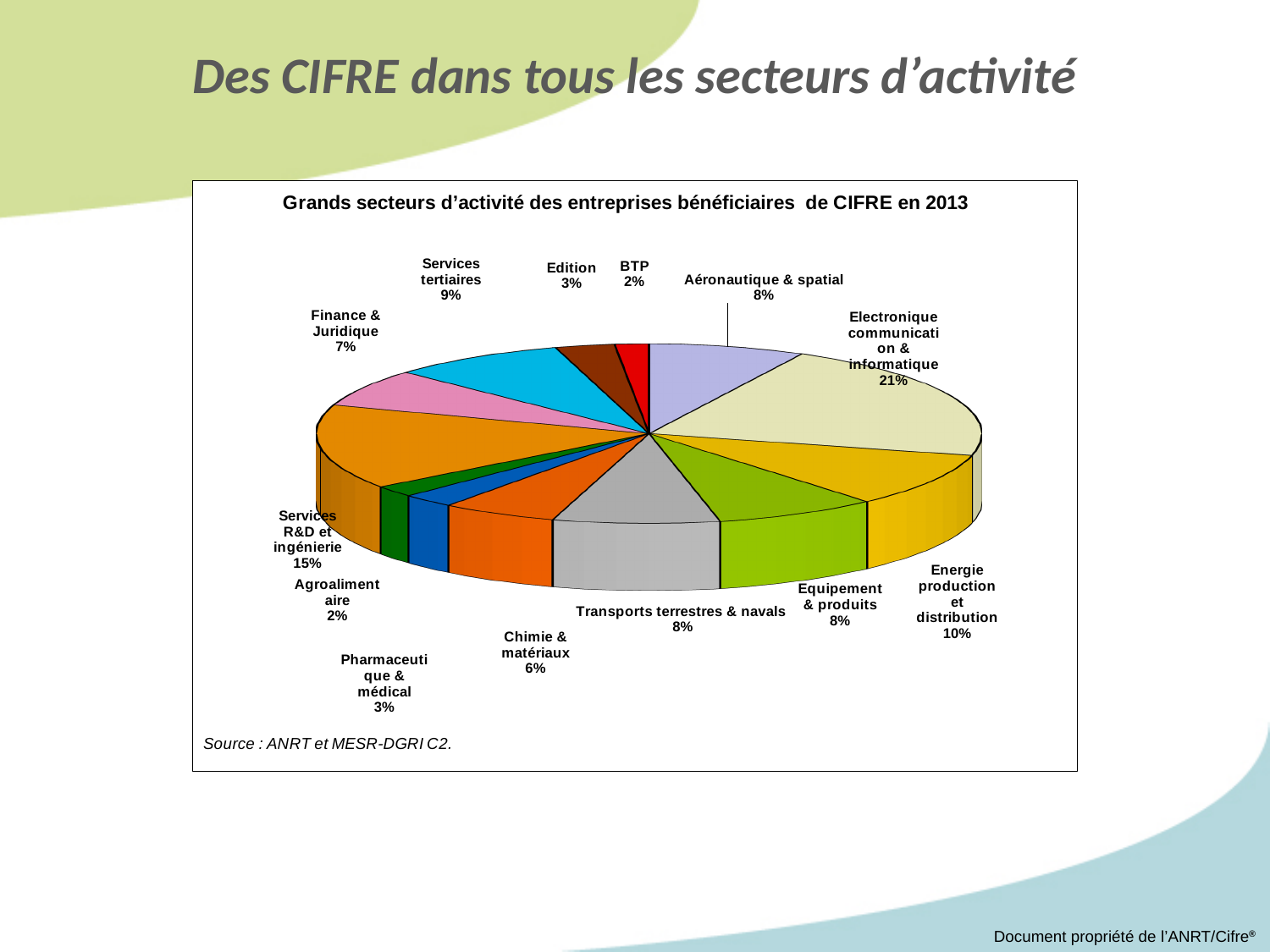
What is the value shown for Energie production et distribution? 10% What type of chart is shown on the slide? Pie chart What is the title of the chart? Grands secteurs d'activité des entreprises bénéficiaires de CIFRE en 2013 What is the value shown for Services R&D et ingénierie? 15% Which has a larger share, Services tertiaires or Aéronautique & spatial? Services tertiaires Which sector has the largest share of the pie? Electronique communication & informatique What is the difference between the shares of Electronique communication & informatique and Services R&D et ingénierie? 6% What share of the pie does Electronique communication & informatique represent? 21% What is the value shown for Finance & Juridique? 7% What is the value shown for Chimie & matériaux? 6% How many sectors (slices) are shown in the pie chart? 13 What source is cited below the chart? ANRT et MESR-DGRI C2